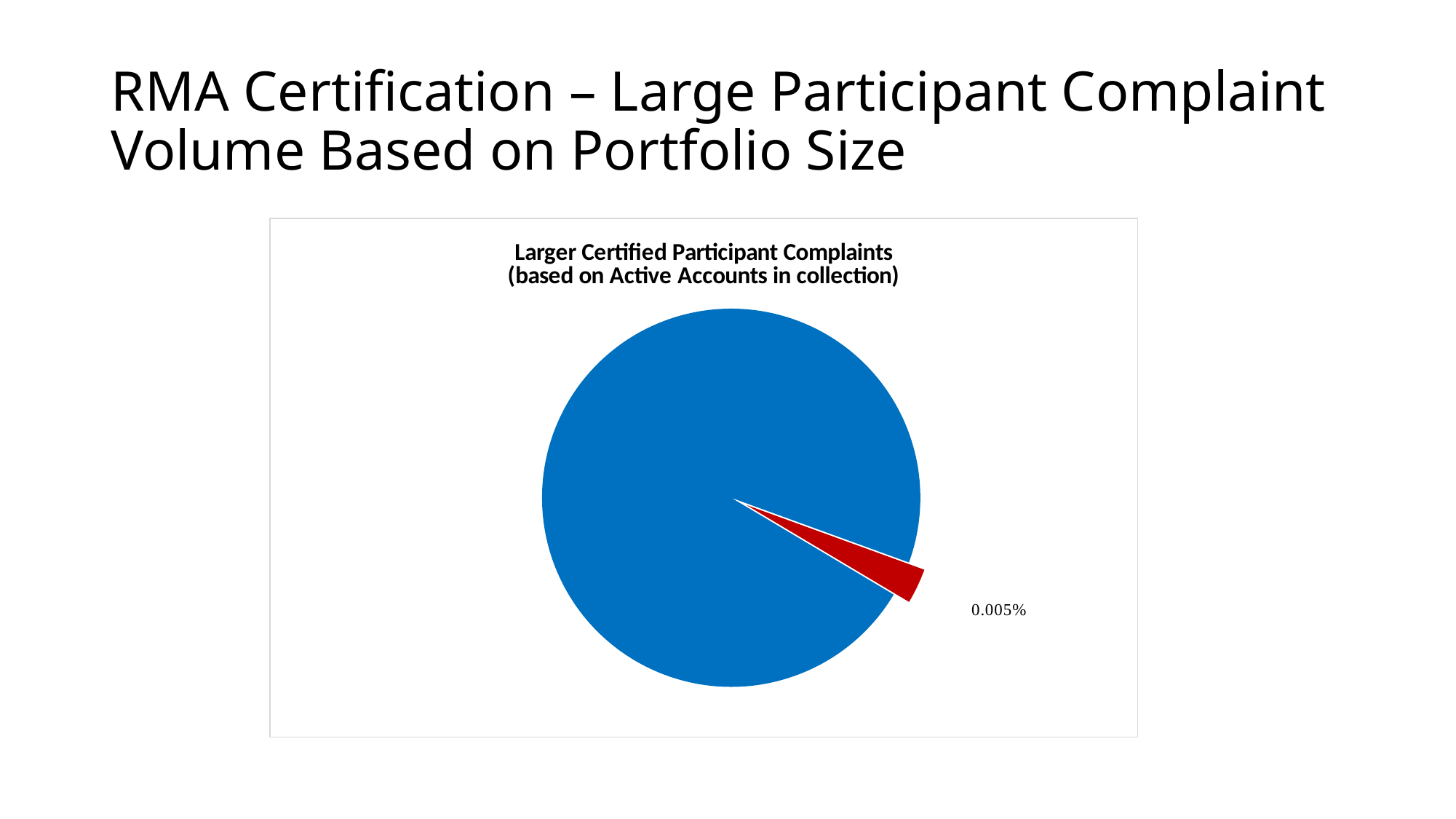
Which colour is the smallest slice of the pie chart? Red What two colours are used for the slices of the pie chart? Blue and red What kind of chart is shown on the slide? Pie chart Which colour is the largest slice of the pie chart? Blue What is the title of the chart? Larger Certified Participant Complaints (based on Active Accounts in collection) What percentage is printed next to the red slice of the pie chart? 0.005% How many slices does the pie chart have? 2 Which slice of the pie chart is larger, the blue slice or the red slice? The blue slice